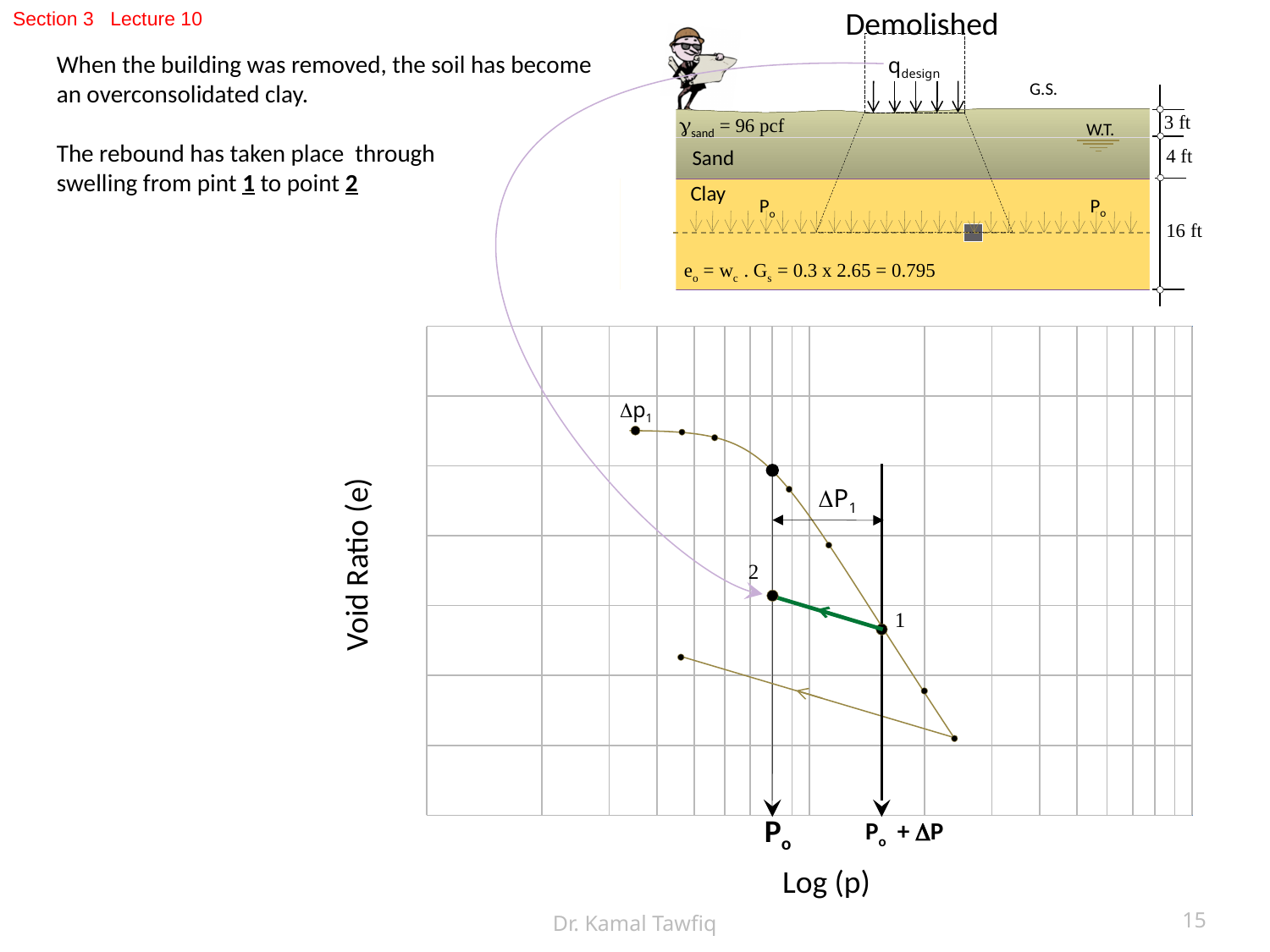
Which labeled point lies at the larger value of Log (p), point 1 or point 2? point 1 What is the label on the vertical axis of the chart? Void Ratio (e) Which of the two marked pressures on the horizontal axis is larger, Po or Po + ΔP? Po + ΔP Along the main curve, does the void ratio rise or fall as Log (p) increases? fall At which marked pressure on the horizontal axis does point 1 lie? Po + ΔP How many numbered points (1, 2, ...) are labeled on the chart? 2 At which marked pressure on the horizontal axis does point 2 lie? Po What is the label on the horizontal axis of the chart? Log (p) In which direction does the green arrow between points 1 and 2 point, toward point 1 or toward point 2? toward point 2 Which labeled point has the higher void ratio, point 1 or point 2? point 2 What kind of chart is shown on the slide? line chart